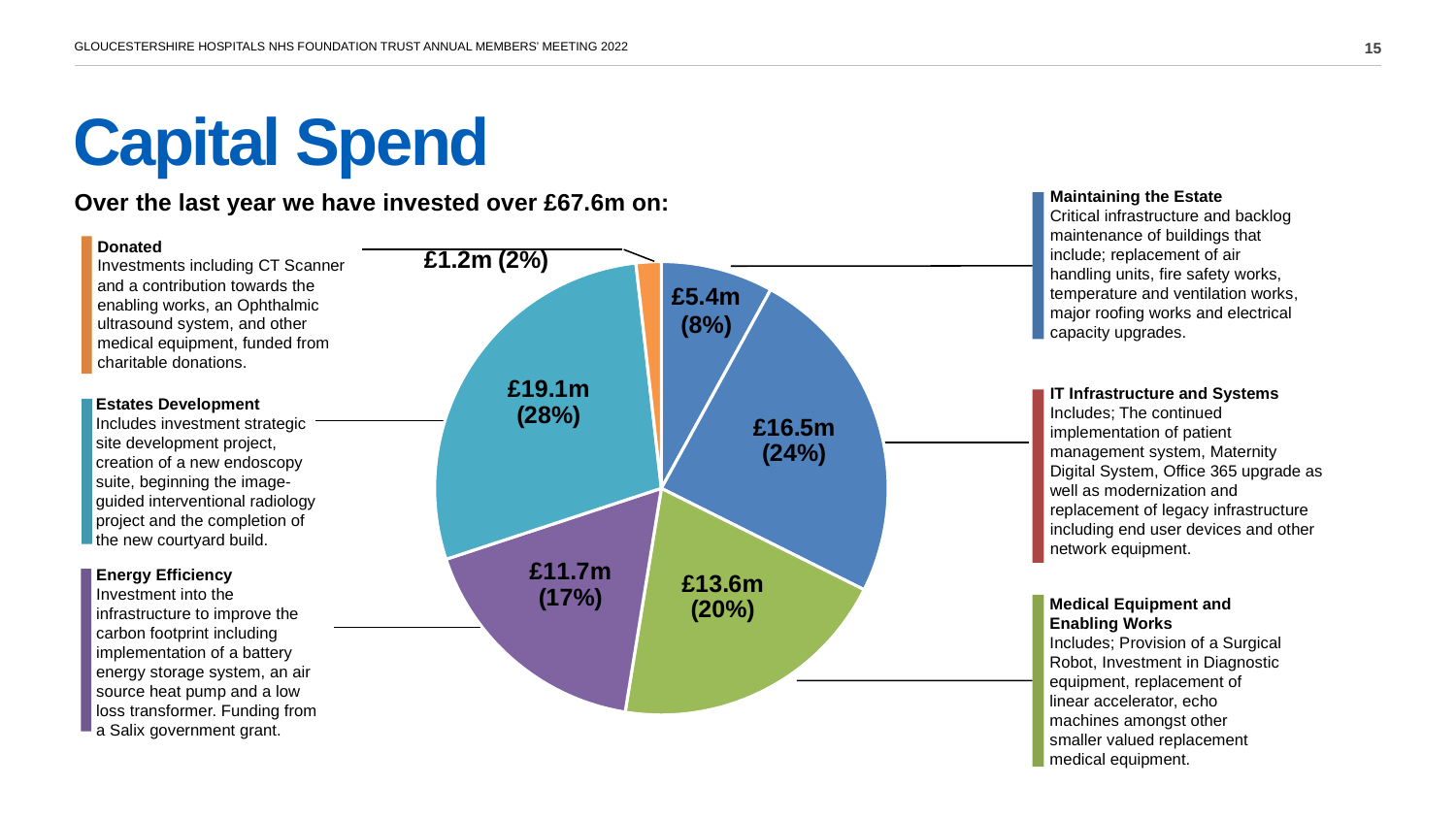
What total investment amount is stated in the subtitle above the chart? £67.6m Which category has the largest slice of the pie? Estates Development What is the value of the Donated slice? £1.2m What is the difference between the Estates Development value and the Energy Efficiency value? £7.4m Which category has the smallest slice of the pie? Donated Which is larger, the Maintaining the Estate slice or the Energy Efficiency slice? Energy Efficiency What percentage share does the IT Infrastructure and Systems slice represent? 24% What is the value of the Medical Equipment and Enabling Works slice? £13.6m What percentage share does the Energy Efficiency slice represent? 17% What kind of chart is shown on the slide? pie chart How many slices does the pie chart have? 6 What is the value of the Estates Development slice? £19.1m